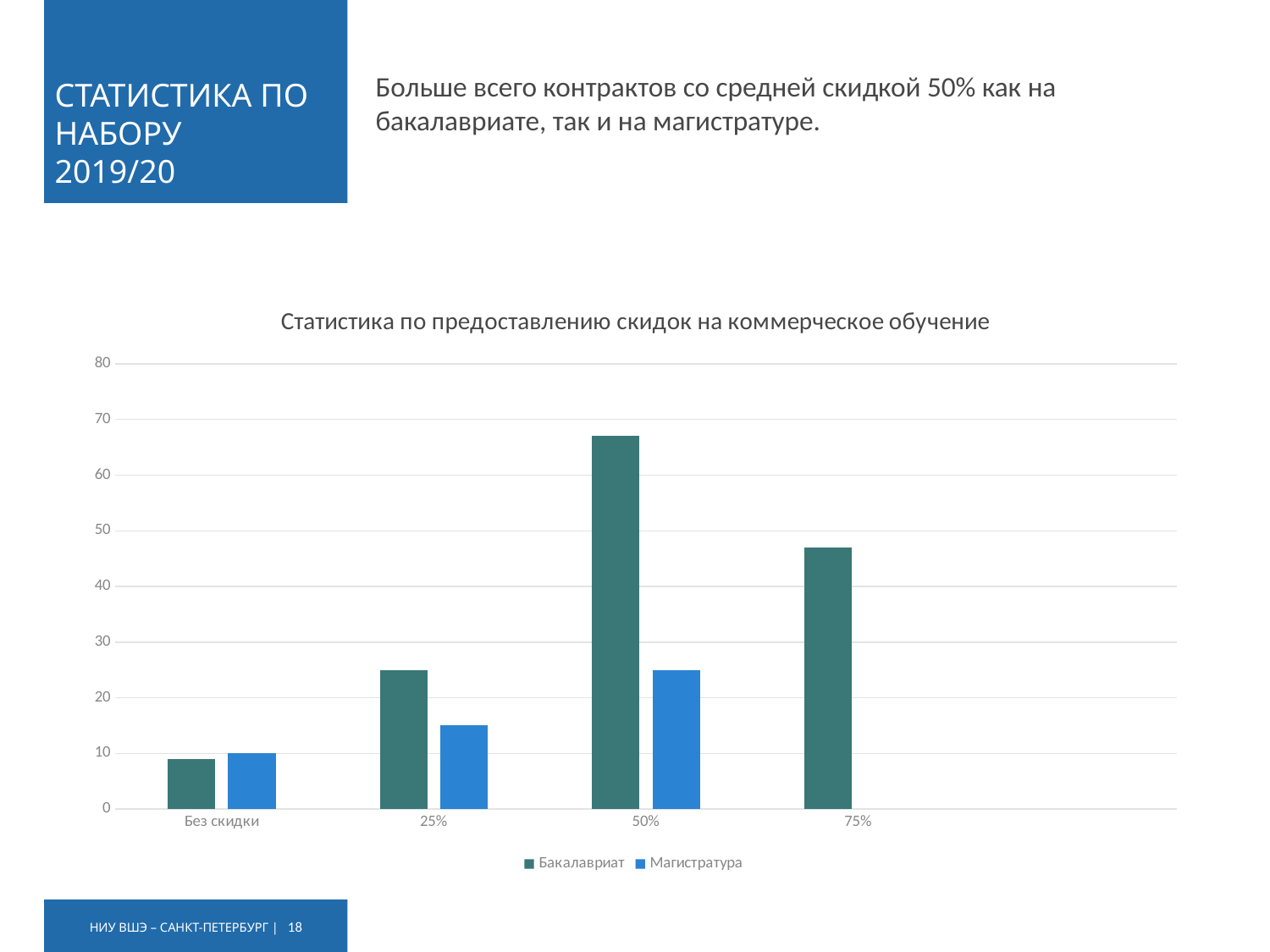
Is the Магистратура value for 25% greater or less than 20? less How many categories are shown on the x axis? 4 Which series has the larger value for the 25% category, Бакалавриат or Магистратура? Бакалавриат What type of chart is shown on the slide? bar chart What is the title of the chart? Статистика по предоставлению скидок на коммерческое обучение How many series does the legend list? 2 Is the Бакалавриат value for 75% greater or less than 50? less Is the Бакалавриат value for 50% greater or less than 60? greater For which category is the Бакалавриат value highest? 50% Which series is shown in the lighter blue colour? Магистратура For which category is the Бакалавриат value lowest? Без скидки For which category is the Магистратура value highest? 50%